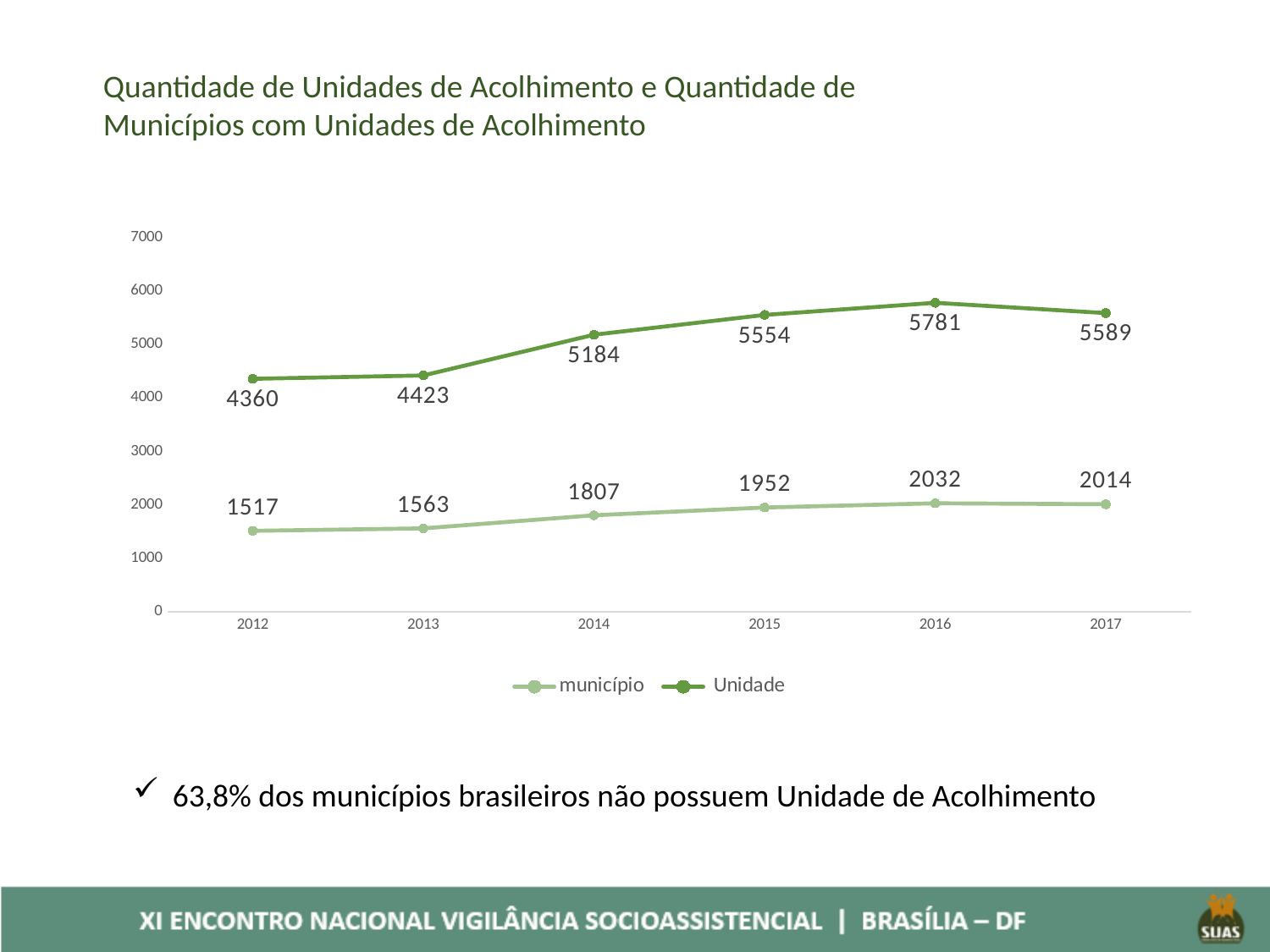
In which year is the Unidade series highest? 2016 In which year is the município series lowest? 2012 What kind of chart is shown on the slide? line chart What is the difference between the Unidade value in 2016 and the Unidade value in 2017? 192 Is the Unidade value in 2016 greater or less than 6000? less How many series does the legend list? 2 What is the value of the Unidade series in 2014? 5184 Which is larger: the Unidade value in 2013 or the Unidade value in 2015? 2015 What is the value of the Unidade series in 2012? 4360 What is the value of the município series in 2016? 2032 How many years are shown on the x axis? 6 What is the difference between the município value in 2015 and the município value in 2014? 145